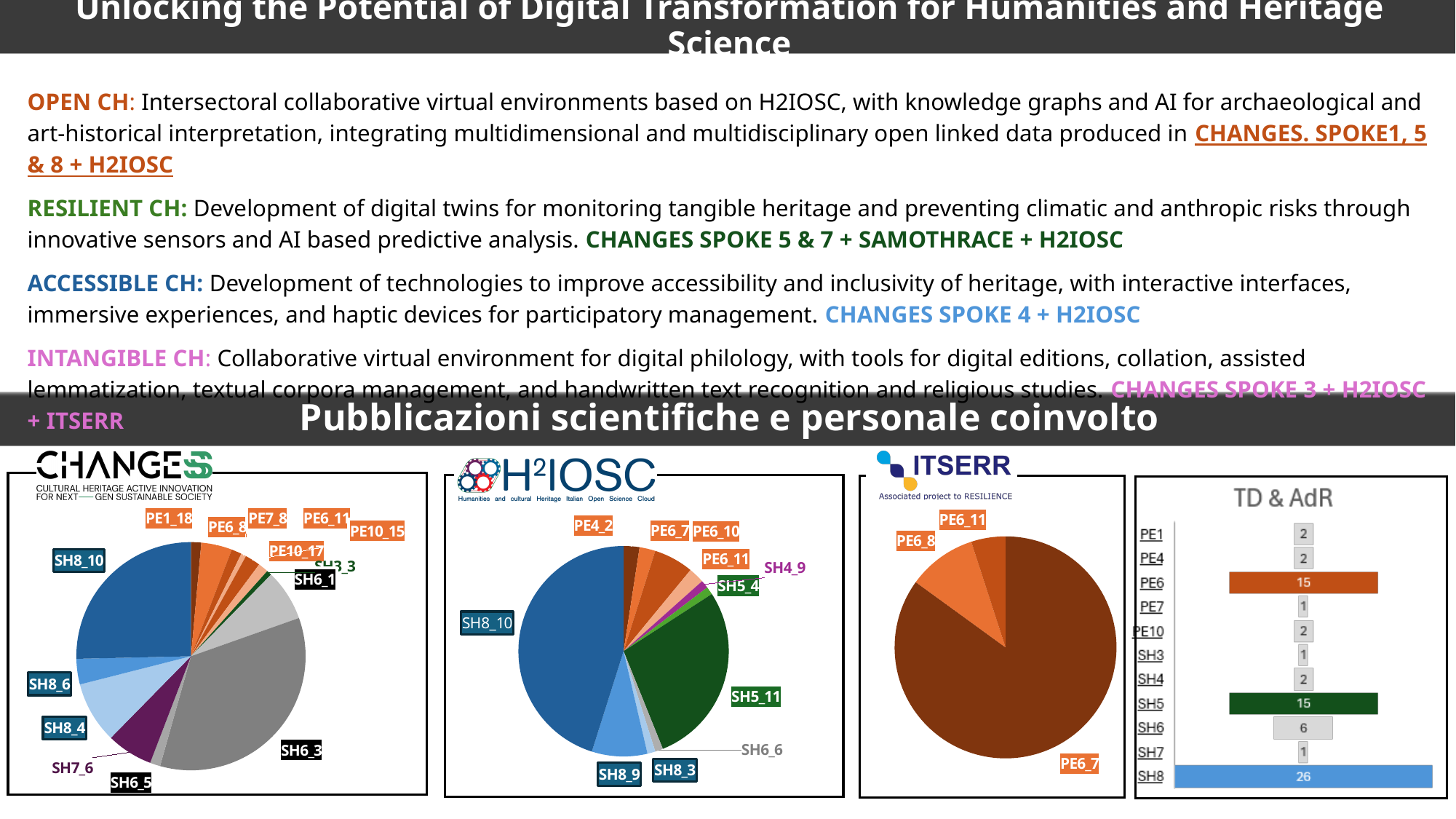
In the TD & AdR chart, which has the larger value, SH6 or SH4? SH6 In the TD & AdR chart, what is the value for SH8? 26 What kind of chart is the CHANGES chart? pie chart In the TD & AdR chart, which category has the highest value? SH8 In the TD & AdR chart, what is the value for PE6? 15 In the ITSERR pie chart, which slice is the largest? PE6_7 In the TD & AdR chart, what is the difference between the values for SH8 and PE6? 11 What kind of chart is the TD & AdR chart? bar chart How many slices does the ITSERR pie chart have? 3 How many categories are shown in the TD & AdR chart? 11 In the TD & AdR chart, what is the value for SH6? 6 In the H2IOSC pie chart, which slice is the largest? SH8_10